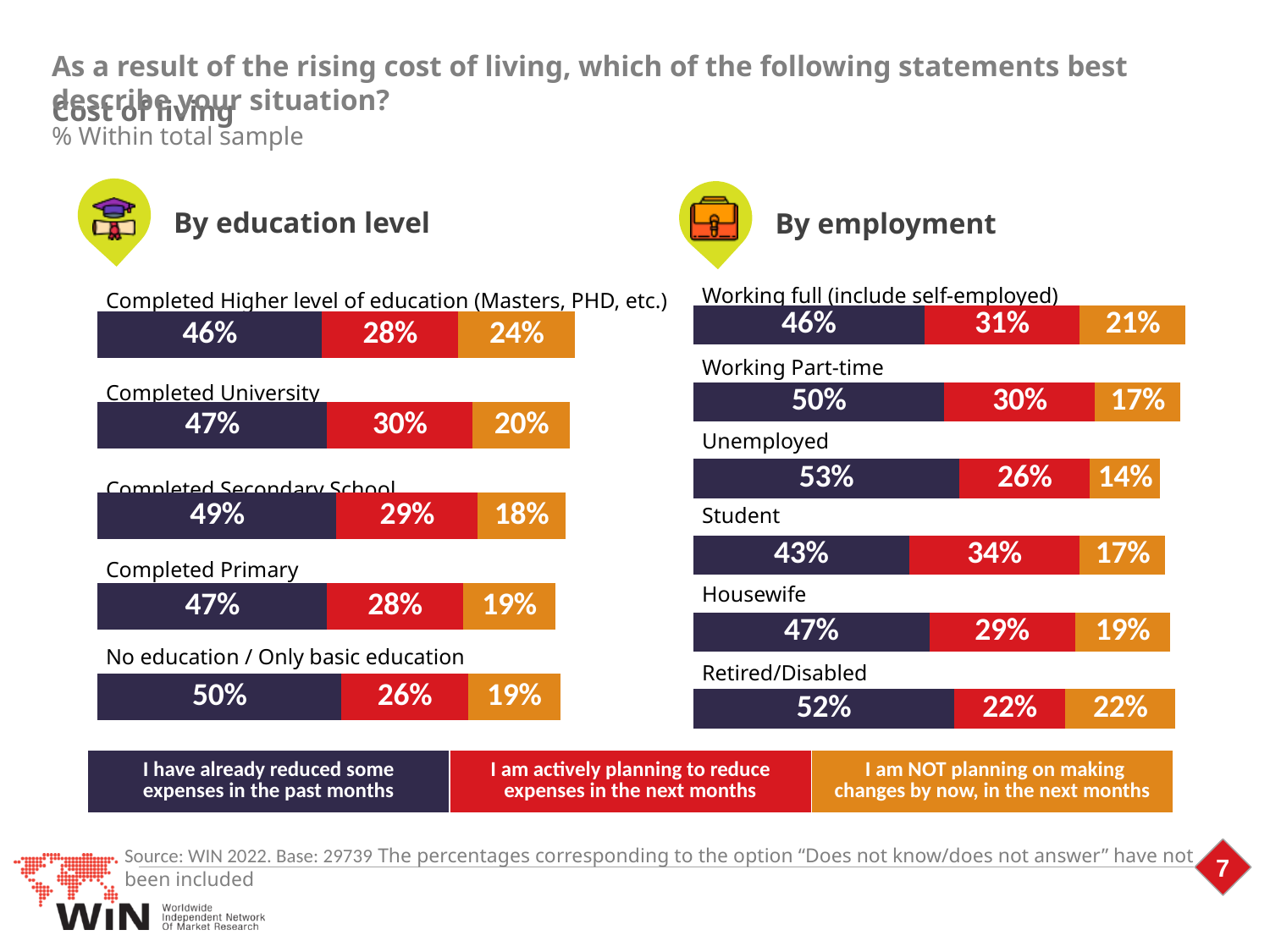
What type of chart is used in the 'By education level' section? Stacked bar chart In the 'By education level' chart, what percentage of respondents who completed a higher level of education (Masters, PHD, etc.) are NOT planning on making changes? 24% How many education categories are shown in the 'By education level' chart? 5 In the 'By employment' chart, what percentage of Students are actively planning to reduce expenses in the next months? 34% In the 'By employment' chart, what is the difference between the share of Retired/Disabled respondents and Students who have already reduced some expenses? 9 percentage points How many series does the legend at the bottom of the slide list? 3 In the 'By education level' chart, which education group has the highest share of respondents who have already reduced some expenses? No education / Only basic education How many employment categories are shown in the 'By employment' chart? 6 In the 'By employment' chart, which employment group has the lowest share of respondents who are NOT planning on making changes? Unemployed In the 'By employment' chart, which employment group has the highest share of respondents who have already reduced some expenses? Unemployed In the 'By employment' chart, what percentage of Unemployed respondents say they have already reduced some expenses in the past months? 53% In the 'By education level' chart, which is larger: the share of Completed University respondents actively planning to reduce expenses, or the share of Completed Primary respondents actively planning to reduce expenses? Completed University